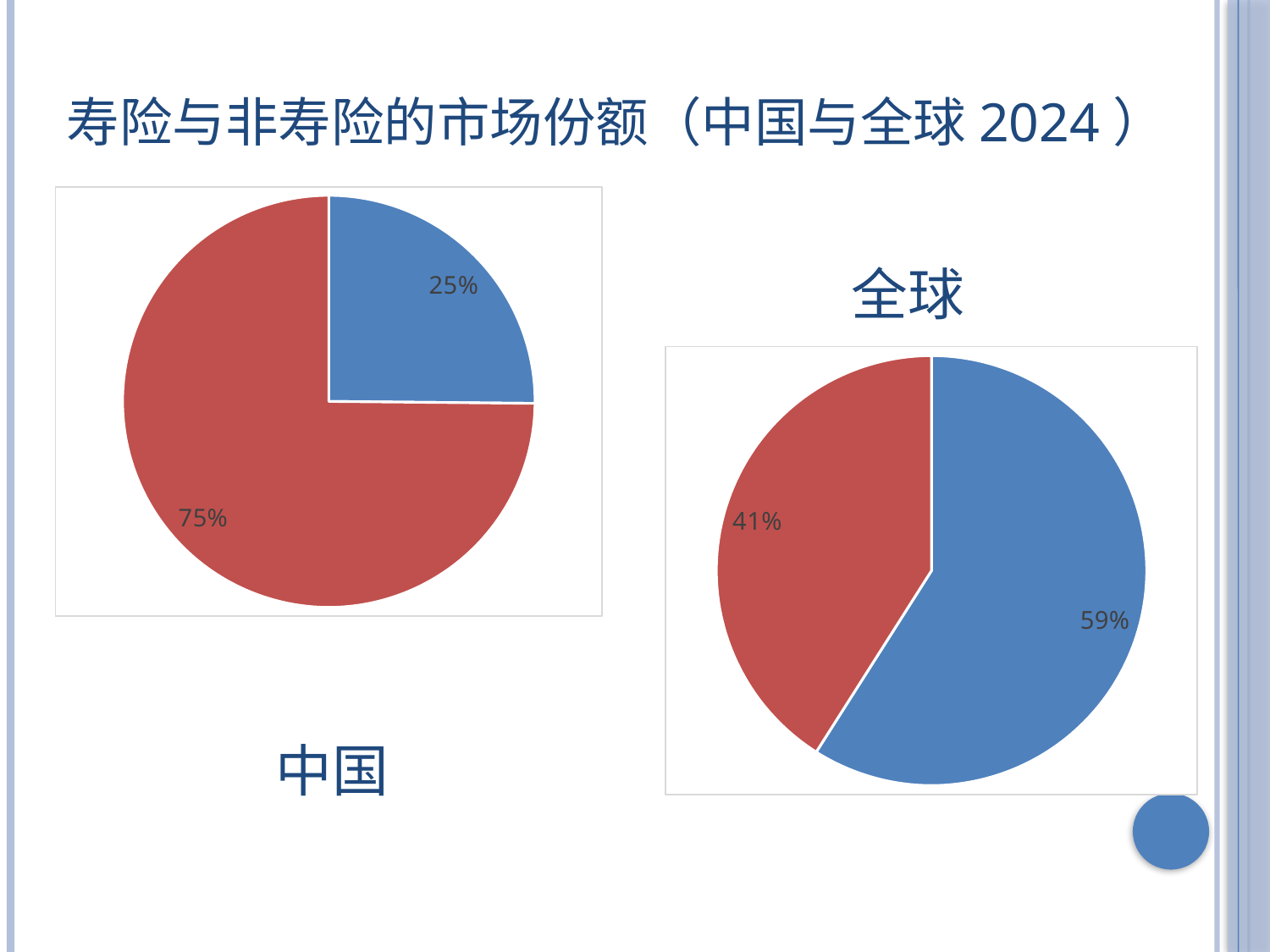
In the 全球 pie chart, what percentage does the red slice show? 41% In the 中国 pie chart, what percentage does the red slice show? 75% In the 中国 pie chart, what percentage does the blue slice show? 25% What type of chart is used for 中国? pie chart Is the blue slice larger in the 中国 pie chart or in the 全球 pie chart? 全球 In the 全球 pie chart, what is the difference between the blue slice and the red slice? 18% How many slices does the 全球 pie chart have? 2 In the 全球 pie chart, what percentage does the blue slice show? 59% In the 中国 pie chart, what is the difference between the red slice and the blue slice? 50% What is the title of the slide? 寿险与非寿险的市场份额（中国与全球 2024） In the 中国 pie chart, which colour slice is the largest? red In the 全球 pie chart, which colour slice is the smallest? red